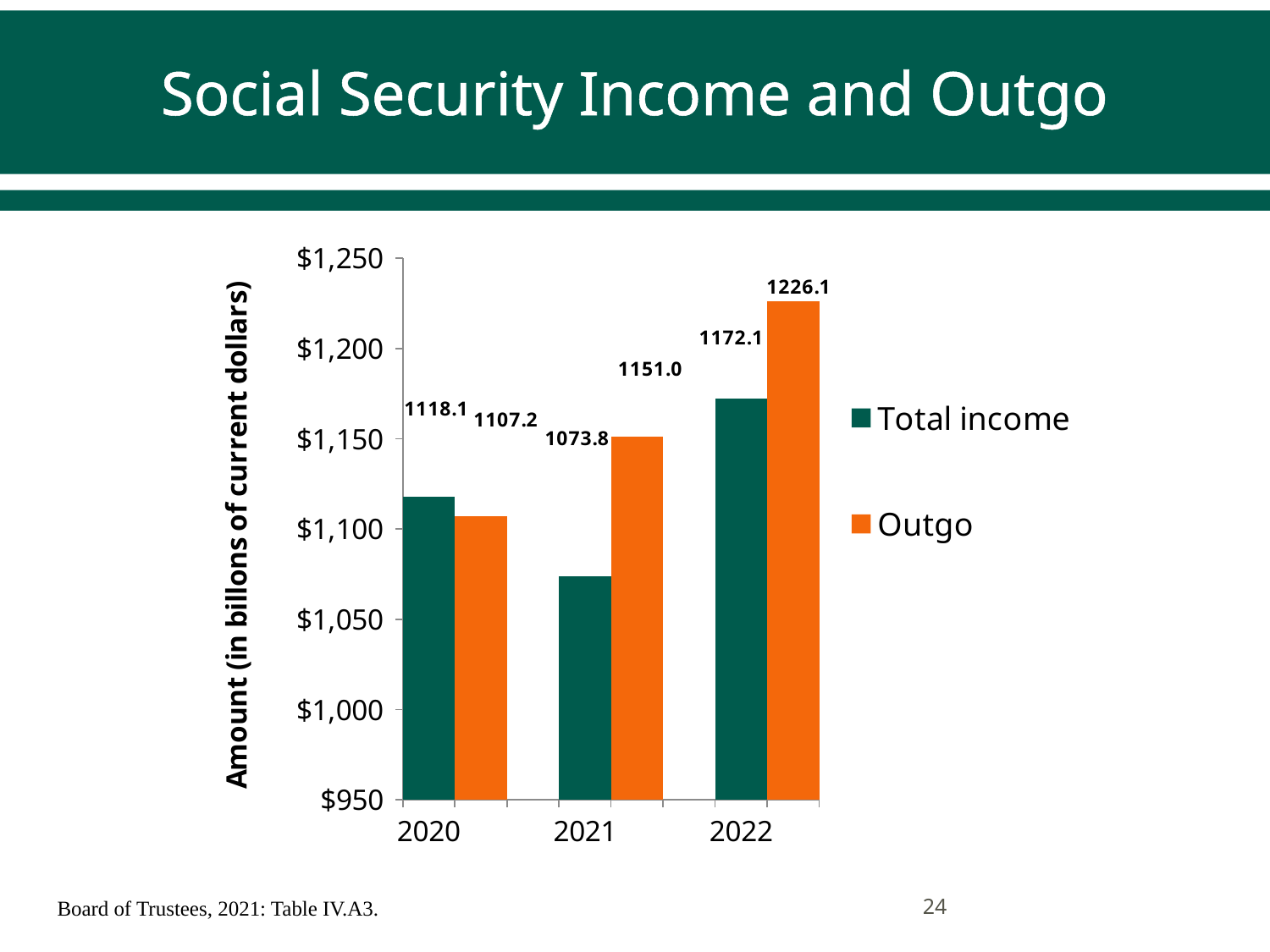
What is the difference between Outgo and Total income in 2021? 77.2 What kind of chart is shown on the slide? bar chart What is the Total income value for 2020? 1118.1 How many series does the legend list? 2 Is the Total income value for 2021 greater or less than $1,100? less Which year has the lowest Outgo? 2020 What is the Outgo value for 2021? 1151.0 What is the Outgo value for 2022? 1226.1 How many years are shown on the x axis? 3 In 2020, which is larger, Total income or Outgo? Total income What is the y-axis label of the chart? Amount (in billons of current dollars) Which year has the highest Total income? 2022